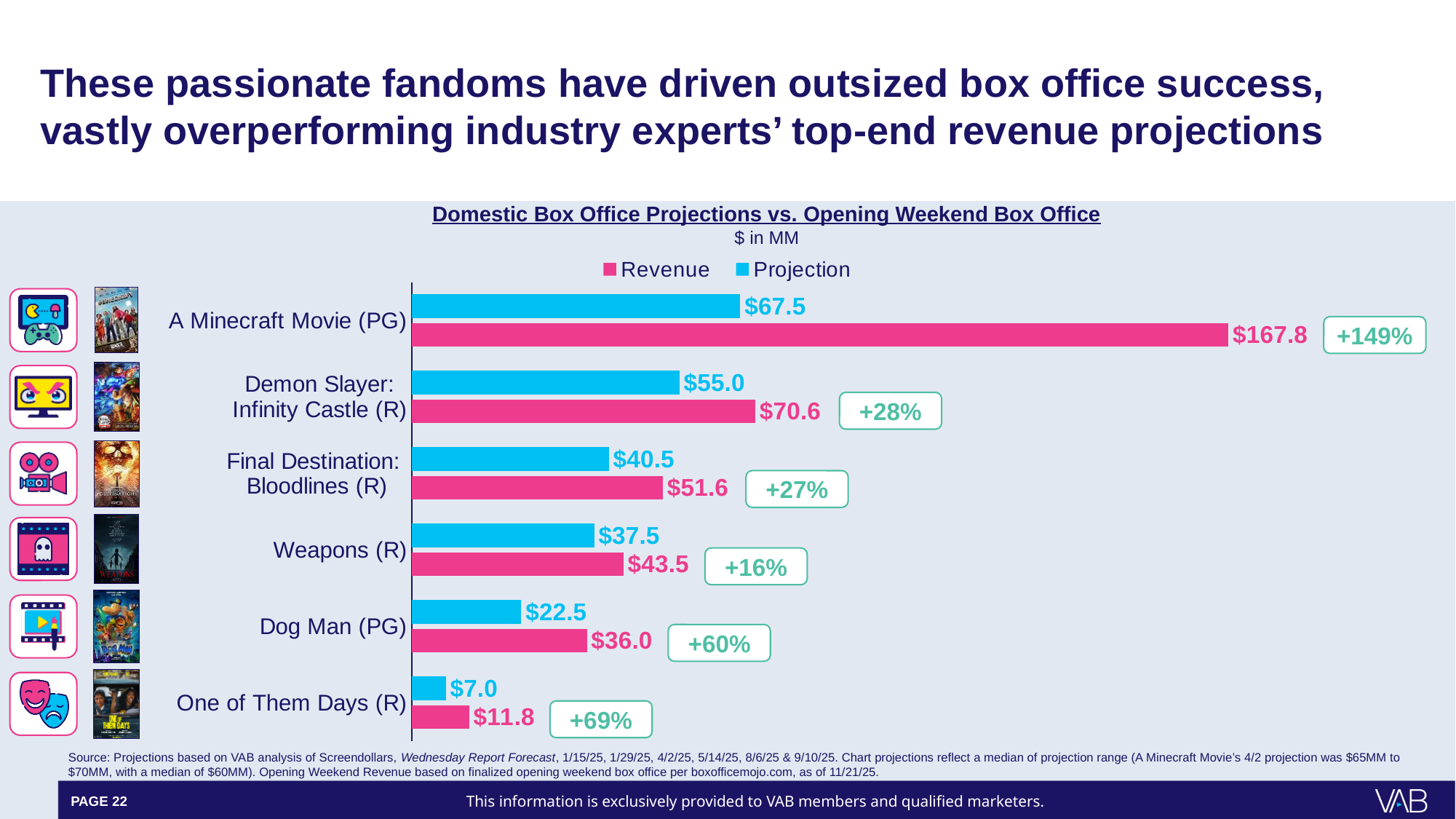
How many movies are shown on the chart? 6 What percentage label is shown next to the bars for One of Them Days (R)? +69% Which movie has the lowest Projection value? One of Them Days (R) What is the Projection value for Demon Slayer: Infinity Castle (R)? $55.0 What is the Revenue value for Dog Man (PG)? $36.0 What kind of chart is shown on the slide? Bar chart How many series does the legend list? 2 Which is larger for Final Destination: Bloodlines (R), the Revenue or the Projection? Revenue What is the title of the chart? Domestic Box Office Projections vs. Opening Weekend Box Office What is the difference between the Revenue and Projection values for Weapons (R)? $6.0 Which movie has the highest Revenue value? A Minecraft Movie (PG) What is the Revenue value for A Minecraft Movie (PG)? $167.8